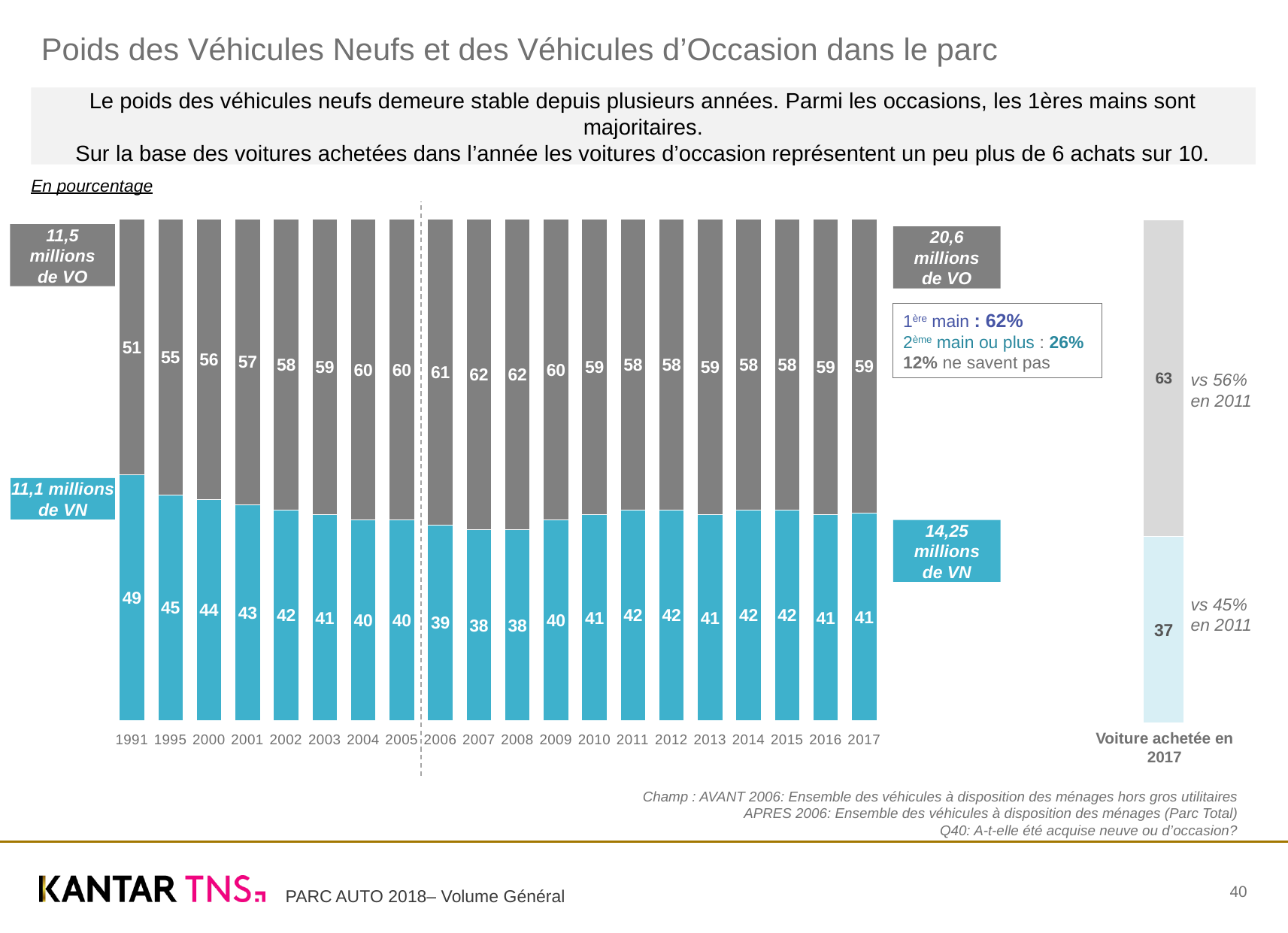
In the main chart, what is the total of the stacked bar for 2006? 100 In the main chart, which year has the larger VN percentage, 2005 or 2010? 2010 In the main chart, what is the percentage of VO (used vehicles) in 2017? 59 How many years are shown on the x axis of the main chart? 20 In the main chart, what is the difference between the VO percentage in 2017 and the VO percentage in 1991? 8 In the main chart, which year has the lowest VO (grey) percentage? 1991 In the 'Voiture achetée en 2017' bar on the right, what is the difference between the grey segment and the blue segment? 26 In the main chart, what is the percentage of VN (new vehicles) in 1991? 49 In the main chart, which year has the highest VN (blue) percentage? 1991 What kind of chart is the main chart on the slide? Stacked bar chart In the 'Voiture achetée en 2017' bar on the right, what is the value of the grey (VO) segment? 63 In the main chart, does the VN (blue) percentage rise or fall from 1991 to 2008? Fall